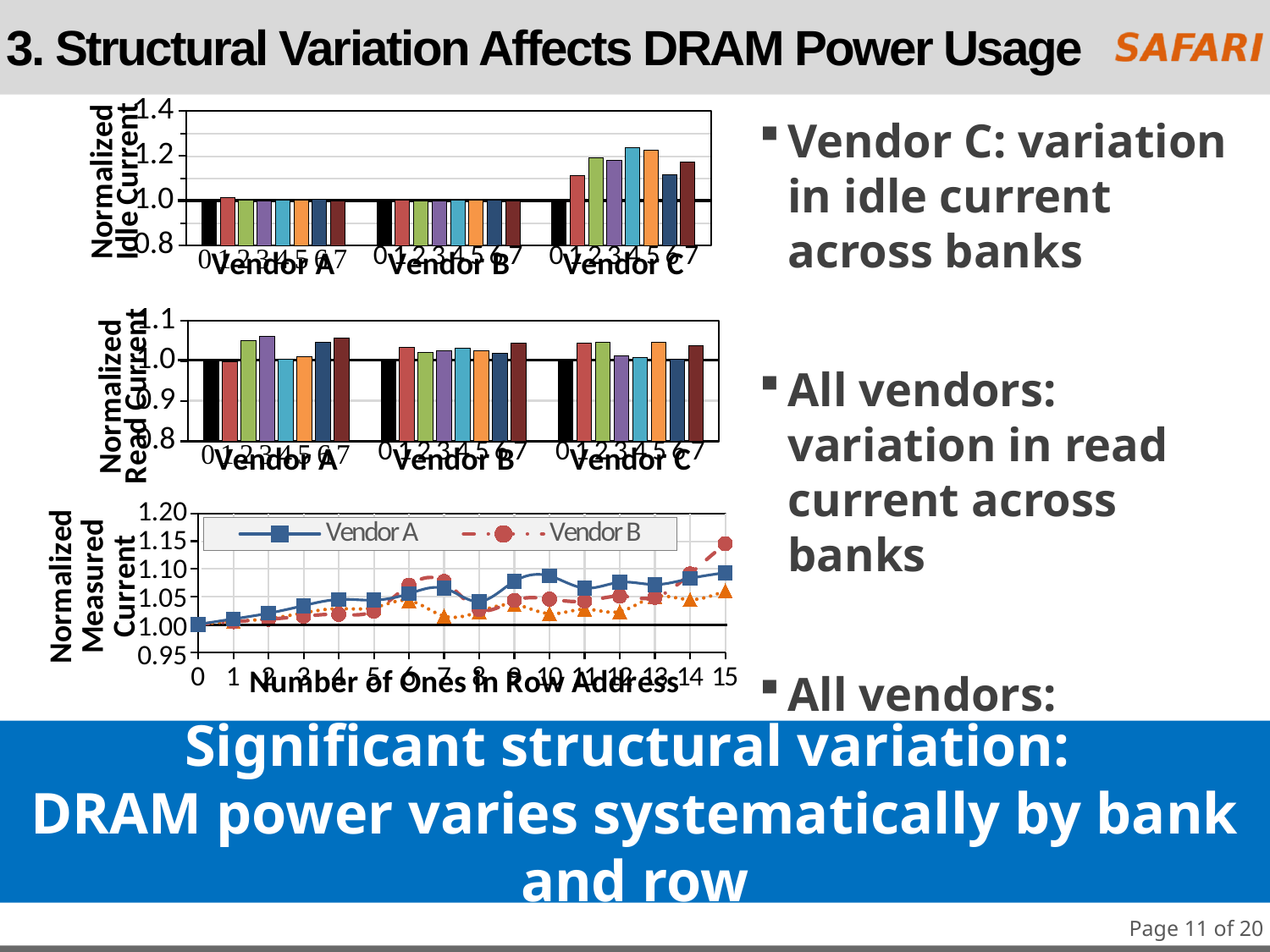
In the top chart (Normalized Idle Current), is the value for Vendor C bank 1 greater or less than 1.2? less In the top chart (Normalized Idle Current), is the value for Vendor C bank 2 greater or less than 1.0? greater In the top chart (Normalized Idle Current), which vendor has the highest idle current bar? Vendor C In the middle chart (Normalized Read Current), how many bars (banks 0 to 7) are shown for Vendor A? 8 In the bottom chart (Normalized Measured Current), which is larger at 15 ones in the row address, Vendor A or Vendor B? Vendor B What kind of chart is the top chart (Normalized Idle Current)? bar chart In the middle chart (Normalized Read Current), is the value for Vendor A bank 3 greater or less than 1.0? greater What kind of chart is the bottom chart (Normalized Measured Current)? line chart In the top chart (Normalized Idle Current), how many vendor groups are shown on the x axis? 3 In the bottom chart (Normalized Measured Current), how many series does the legend list? 2 In the bottom chart (Normalized Measured Current), what is the x-axis title? Number of Ones in Row Address